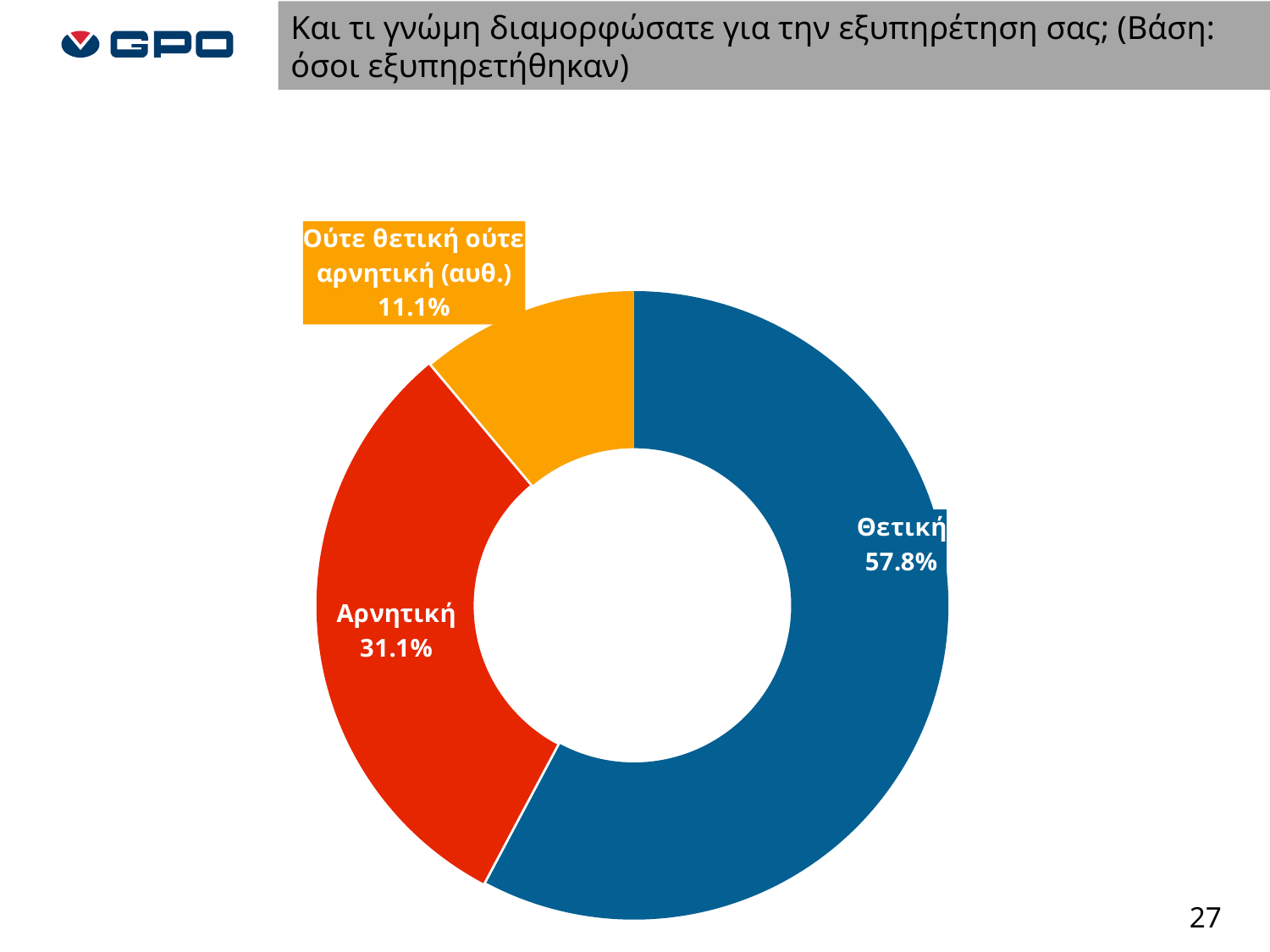
Which category has the smallest share of the chart? Ούτε θετική ούτε αρνητική (αυθ.) What colour is the Θετική segment? Blue How many categories are shown in the chart? 3 What colour is the Αρνητική segment? Red What kind of chart is shown on the slide? Doughnut chart What is the difference in percentage points between Θετική and Αρνητική? 26.7 What percentage of respondents answered Ούτε θετική ούτε αρνητική (αυθ.)? 11.1% Which is larger, the share for Αρνητική or the share for Ούτε θετική ούτε αρνητική (αυθ.)? Αρνητική Which category has the largest share of the chart? Θετική What percentage of respondents answered Αρνητική? 31.1% What percentage of respondents answered Θετική? 57.8% What is the difference in percentage points between Αρνητική and Ούτε θετική ούτε αρνητική (αυθ.)? 20